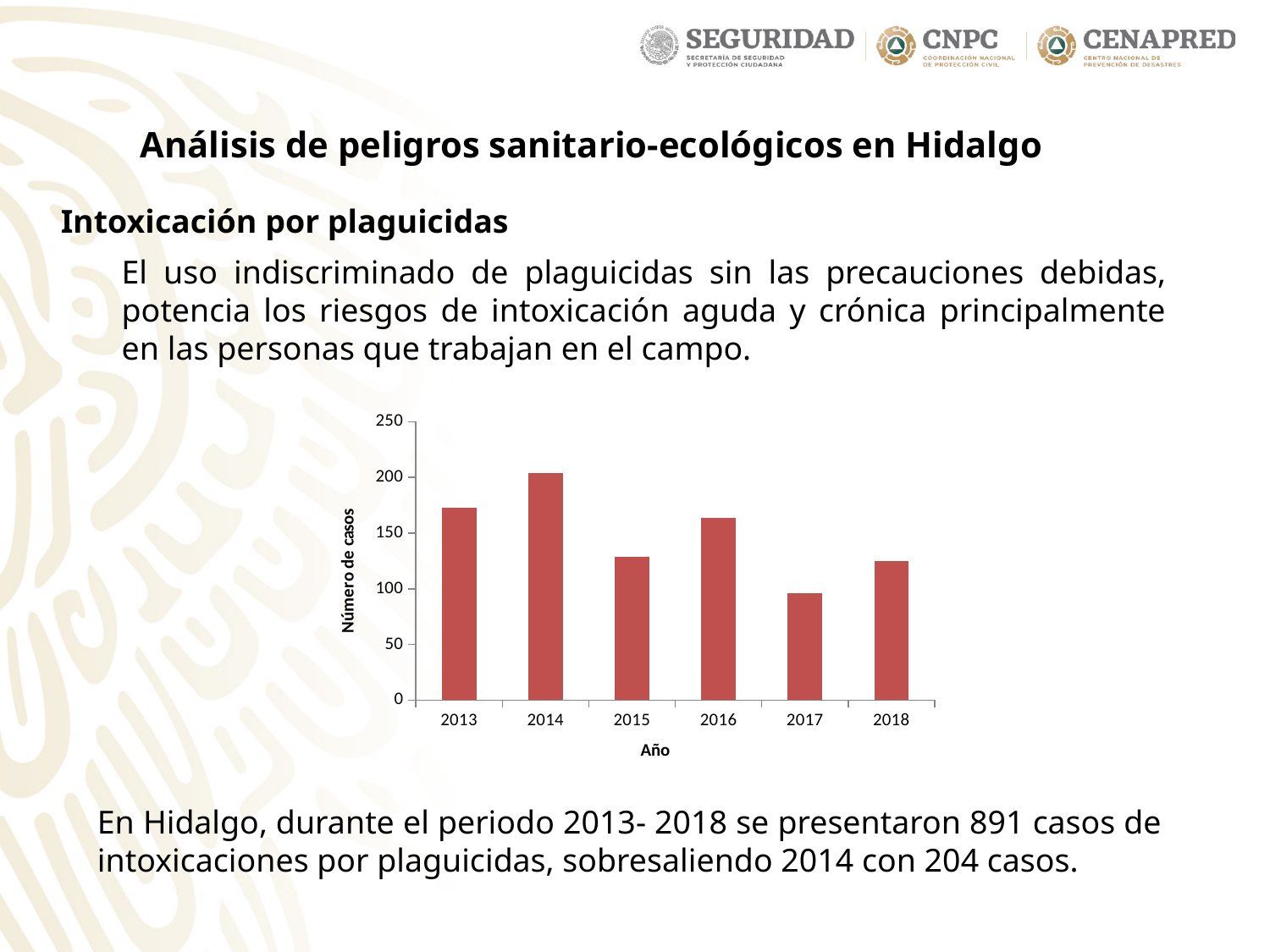
How many years are plotted on the chart? 6 How many cases were recorded in 2014? 204 What is the label on the vertical axis of the chart? Número de casos Is the value for 2015 greater or less than 150? less Which year has the highest number of cases? 2014 Is the value for 2018 greater or less than 100? greater Is the value for 2016 greater or less than 150? greater What kind of chart is shown on the slide? bar chart Which year has more cases, 2013 or 2015? 2013 Do the values rise or fall from 2014 to 2015? fall Which year has the lowest number of cases? 2017